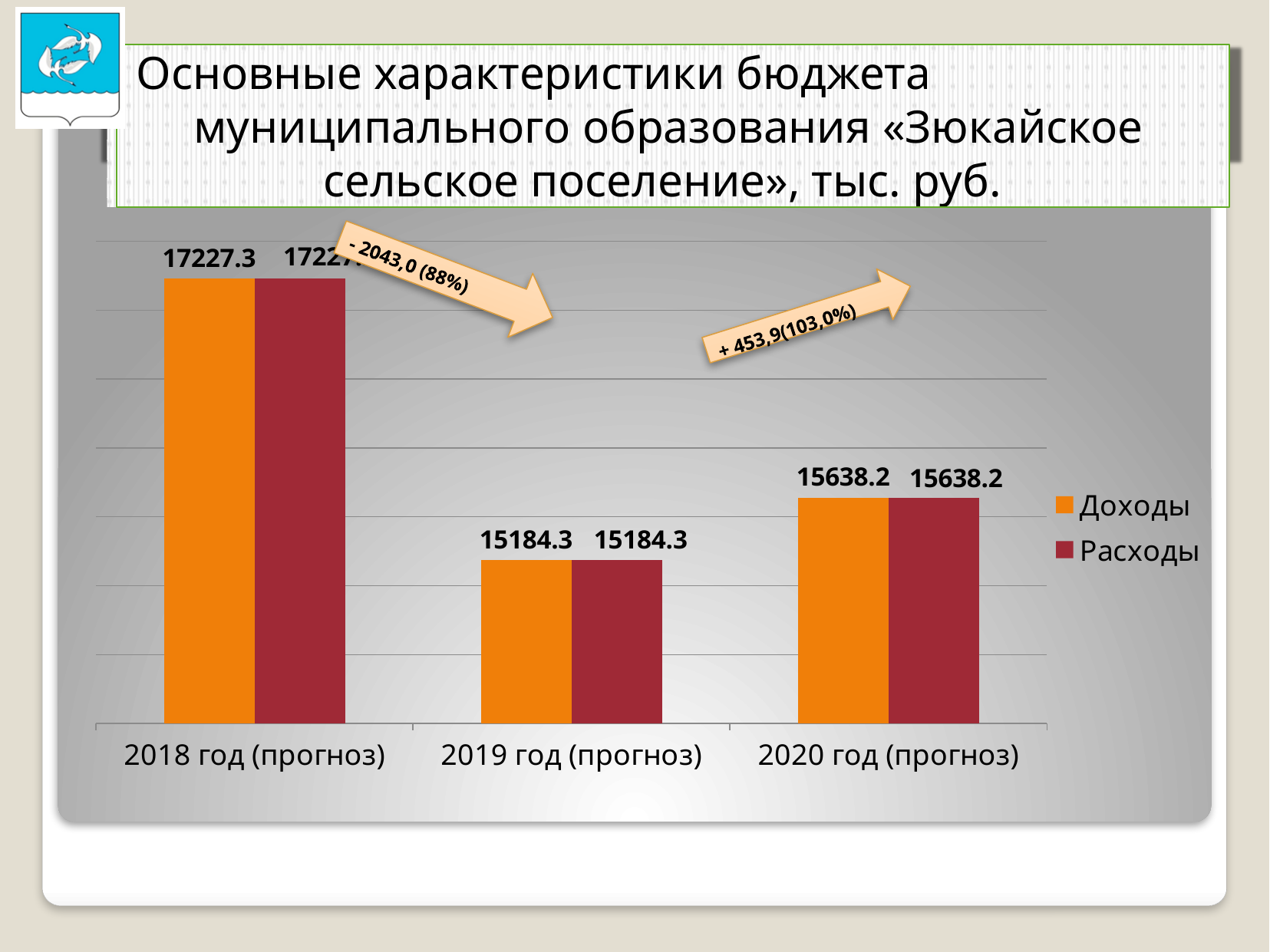
How many series does the legend list? 2 What is the difference between Доходы for 2020 год (прогноз) and Доходы for 2019 год (прогноз)? 453.9 Which year has the lowest value of Доходы? 2019 год (прогноз) What is the value of Расходы for 2019 год (прогноз)? 15184.3 What is the value of Доходы for 2018 год (прогноз)? 17227.3 Which is larger: Доходы for 2019 год (прогноз) or Доходы for 2020 год (прогноз)? 2020 год (прогноз) What is the value of Доходы for 2019 год (прогноз)? 15184.3 By how much is Доходы for 2018 год (прогноз) greater than Доходы for 2019 год (прогноз)? 2043.0 Which year has the highest value of Доходы? 2018 год (прогноз) What is the value of Расходы for 2020 год (прогноз)? 15638.2 What kind of chart is shown on the slide? bar chart How many years (categories) are shown on the x axis? 3